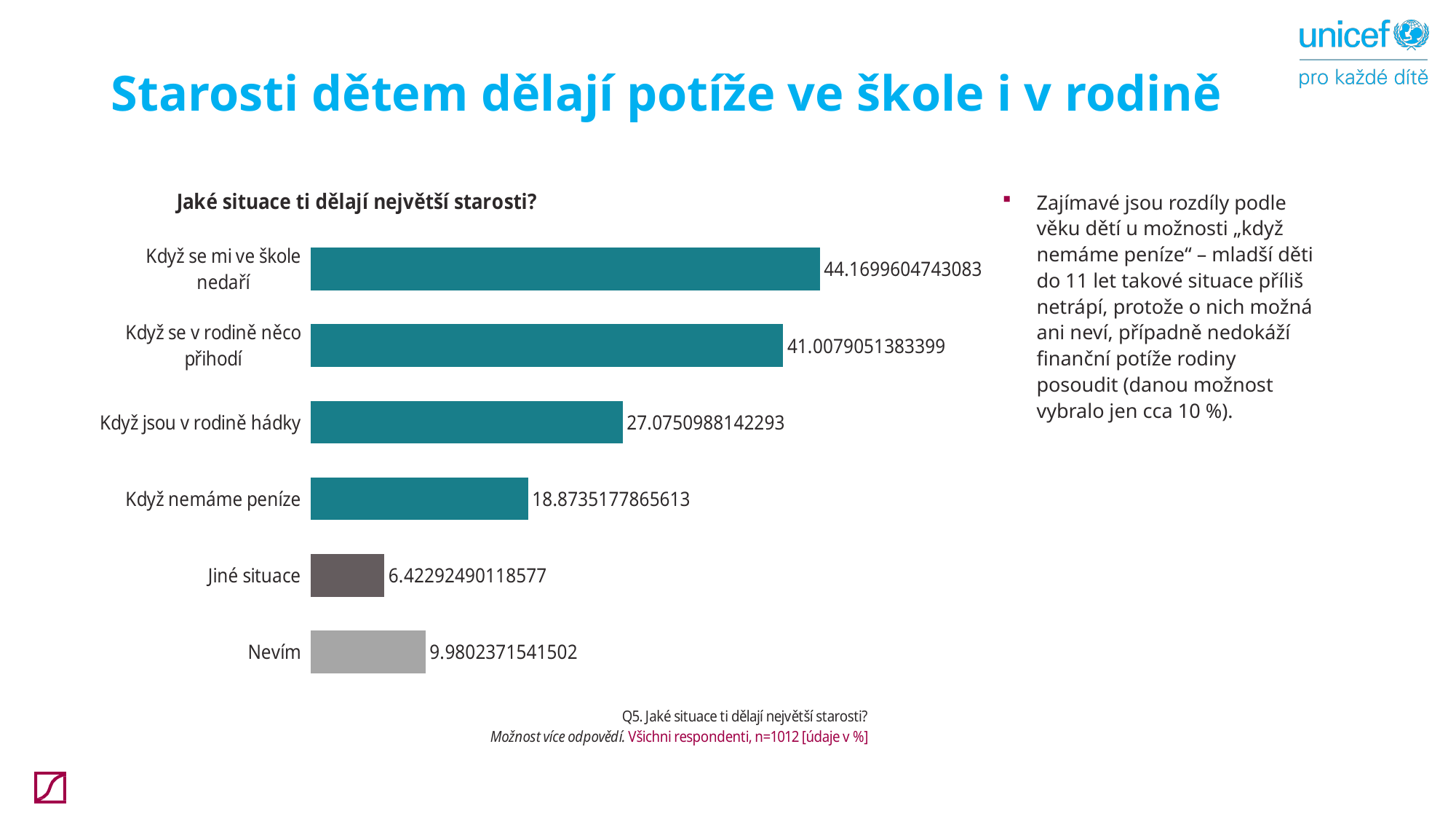
What is the value for "Když nemáme peníze"? 18.8735177865613 What is the difference between the values for "Když se mi ve škole nedaří" and "Když se v rodině něco přihodí"? 3.1620553359684 What is the value for "Nevím"? 9.9802371541502 What is the title of the chart? Jaké situace ti dělají největší starosti? Which category has the highest value? Když se mi ve škole nedaří What type of chart is shown on the slide? bar chart What is the value for "Když se mi ve škole nedaří"? 44.1699604743083 What is the value for "Když jsou v rodině hádky"? 27.0750988142293 Which is larger, the value for "Nevím" or the value for "Jiné situace"? Nevím Which is larger, the value for "Když jsou v rodině hádky" or the value for "Když nemáme peníze"? Když jsou v rodině hádky How many categories are shown in the chart? 6 Which category has the lowest value? Jiné situace